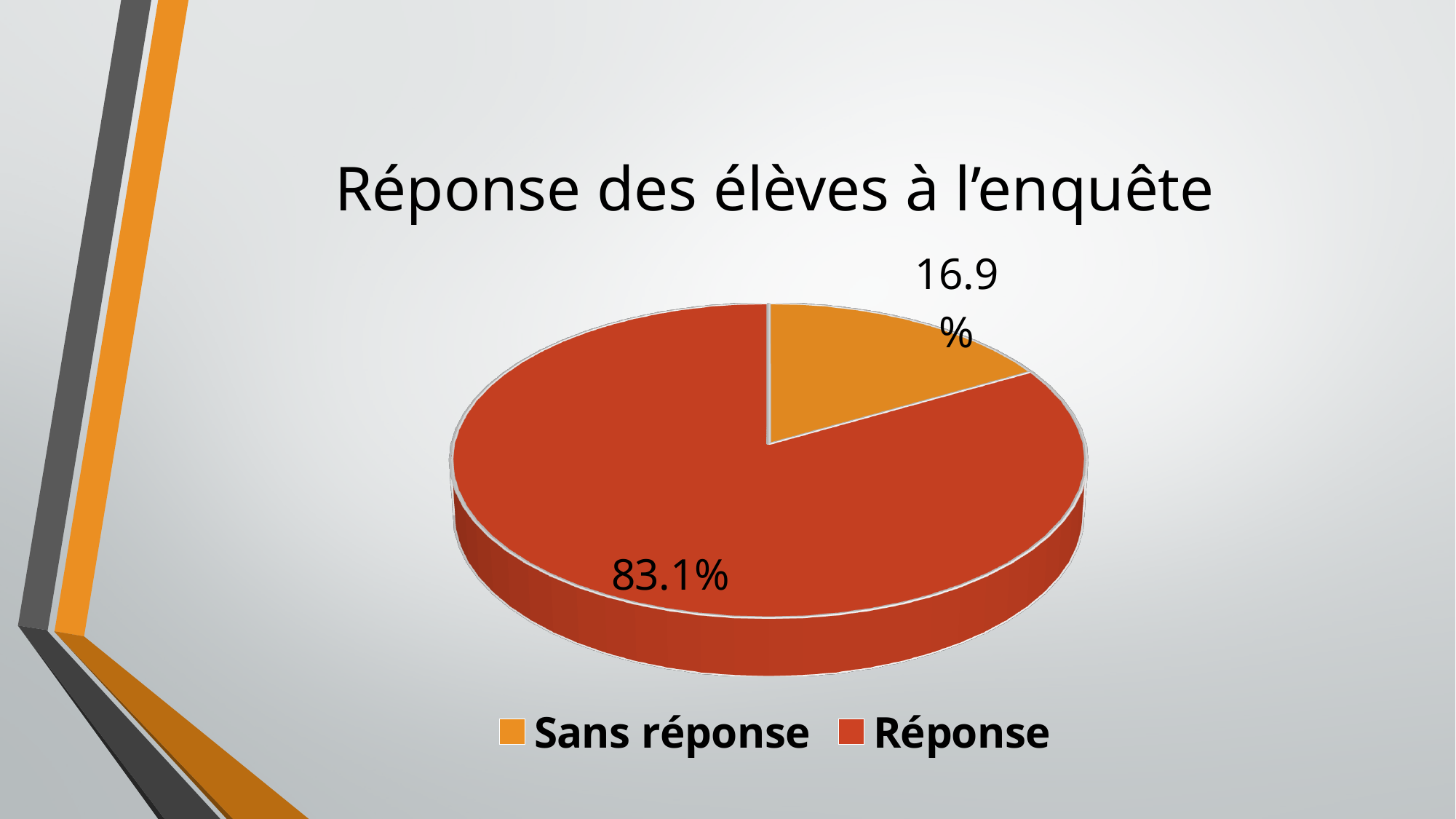
What share of the pie does the "Réponse" slice represent? 83.1% What is the difference in percentage points between the "Réponse" and "Sans réponse" slices? 66.2 Which slice is the largest? Réponse Which is larger, the "Sans réponse" slice or the "Réponse" slice? Réponse What percentage of the pie is labelled "Sans réponse"? 16.9% What colour is the "Sans réponse" slice? Orange What kind of chart is shown on the slide? Pie chart Which slice is the smallest? Sans réponse What percentage of the pie is labelled "Réponse"? 83.1% How many entries does the legend list? 2 What is the title of the chart? Réponse des élèves à l'enquête How many slices does the pie chart have? 2